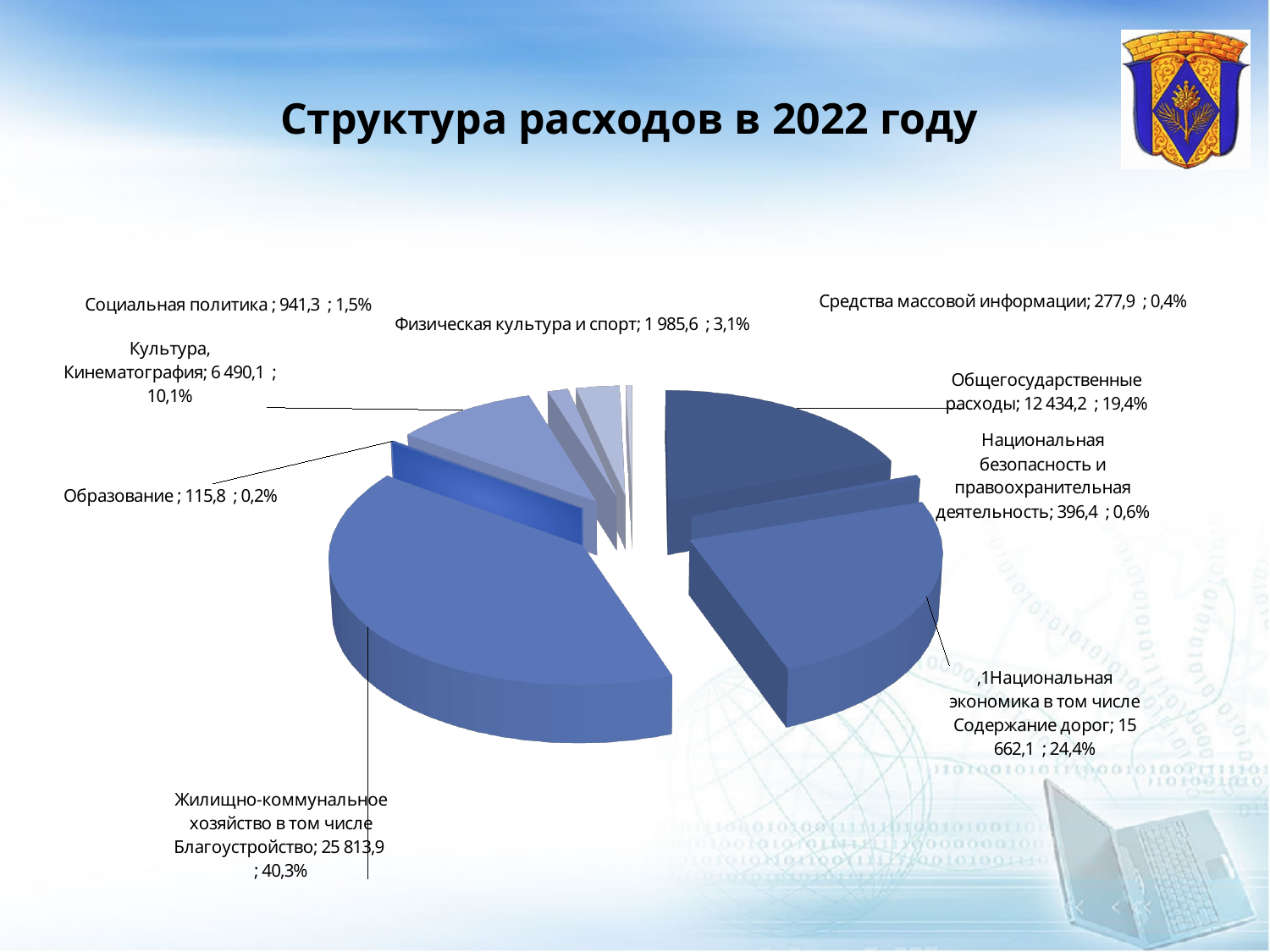
What percentage share is shown for Общегосударственные расходы? 19,4% What percentage share is shown for Национальная экономика в том числе Содержание дорог? 24,4% What is the value shown for Средства массовой информации? 277,9 What is the value shown for Культура, Кинематография? 6 490,1 What is the value shown for Образование? 115,8 What is the title of the chart? Структура расходов в 2022 году Which category has the largest share of the pie? Жилищно-коммунальное хозяйство в том числе Благоустройство How many categories (slices) does the pie chart have? 9 What kind of chart is shown on the slide? Pie chart Which is larger: the value for Социальная политика or the value for Физическая культура и спорт? Физическая культура и спорт What is the difference between the percentage shares of Жилищно-коммунальное хозяйство and Национальная экономика? 15,9% Which category has the smallest share of the pie? Образование